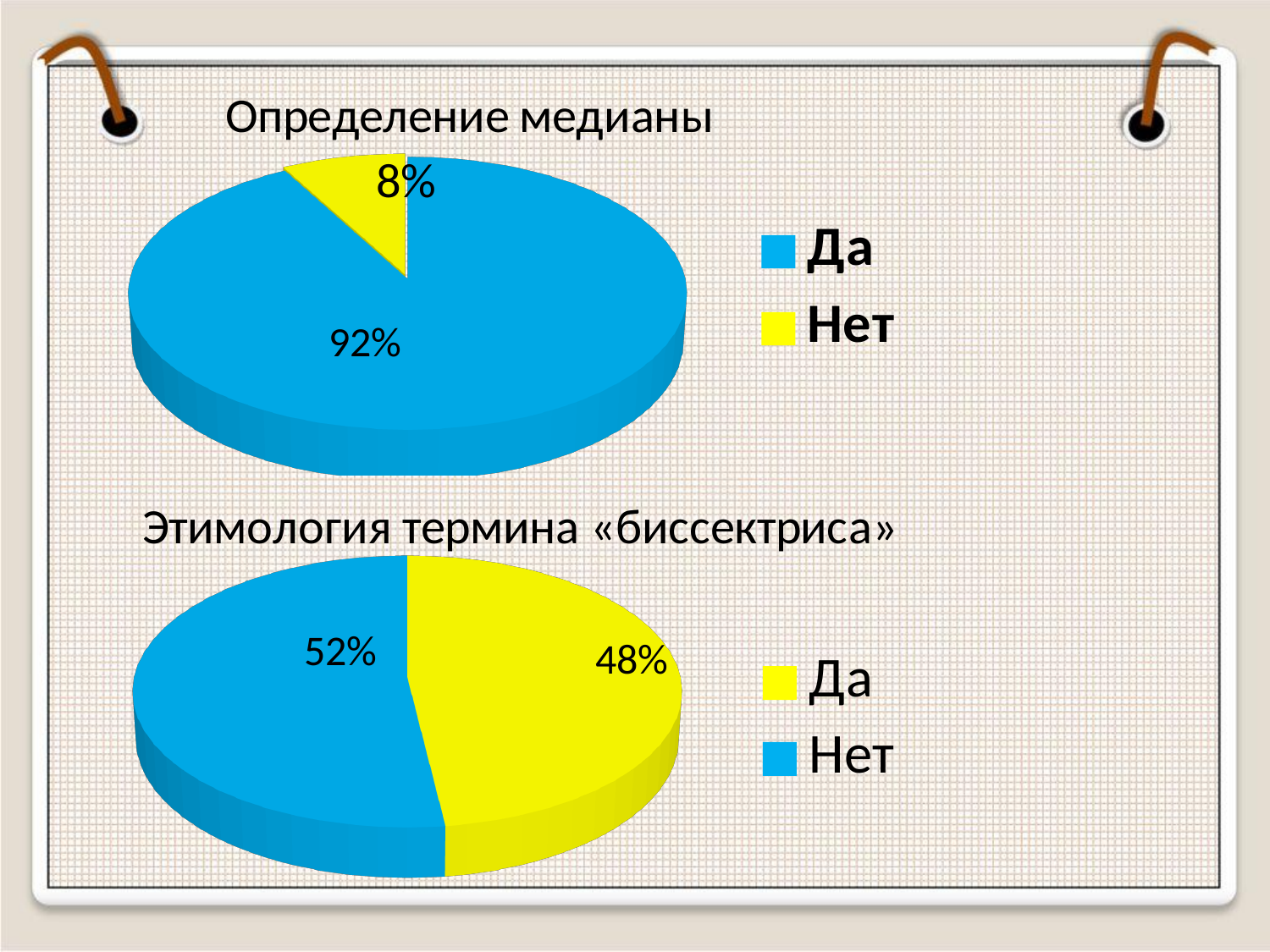
In the chart titled «Определение медианы», what is the difference between the «Да» and «Нет» shares? 84% In the chart titled «Этимология термина «биссектриса»», what is the difference between the «Нет» and «Да» shares? 4% What type of chart is the top chart on the slide? Pie chart In the chart titled «Определение медианы», what share of the pie is labelled «Да»? 92% In the chart titled «Определение медианы», what share of the pie is labelled «Нет»? 8% In the chart titled «Определение медианы», which category has the largest slice? Да In the chart titled «Этимология термина «биссектриса»», what share of the pie is labelled «Да»? 48% How many categories does the legend of the bottom chart list? 2 In the chart titled «Определение медианы», which category has the smallest slice? Нет In the chart titled «Этимология термина «биссектриса»», which is larger, «Да» or «Нет»? Нет In the chart titled «Этимология термина «биссектриса»», what colour is the «Да» slice? Yellow